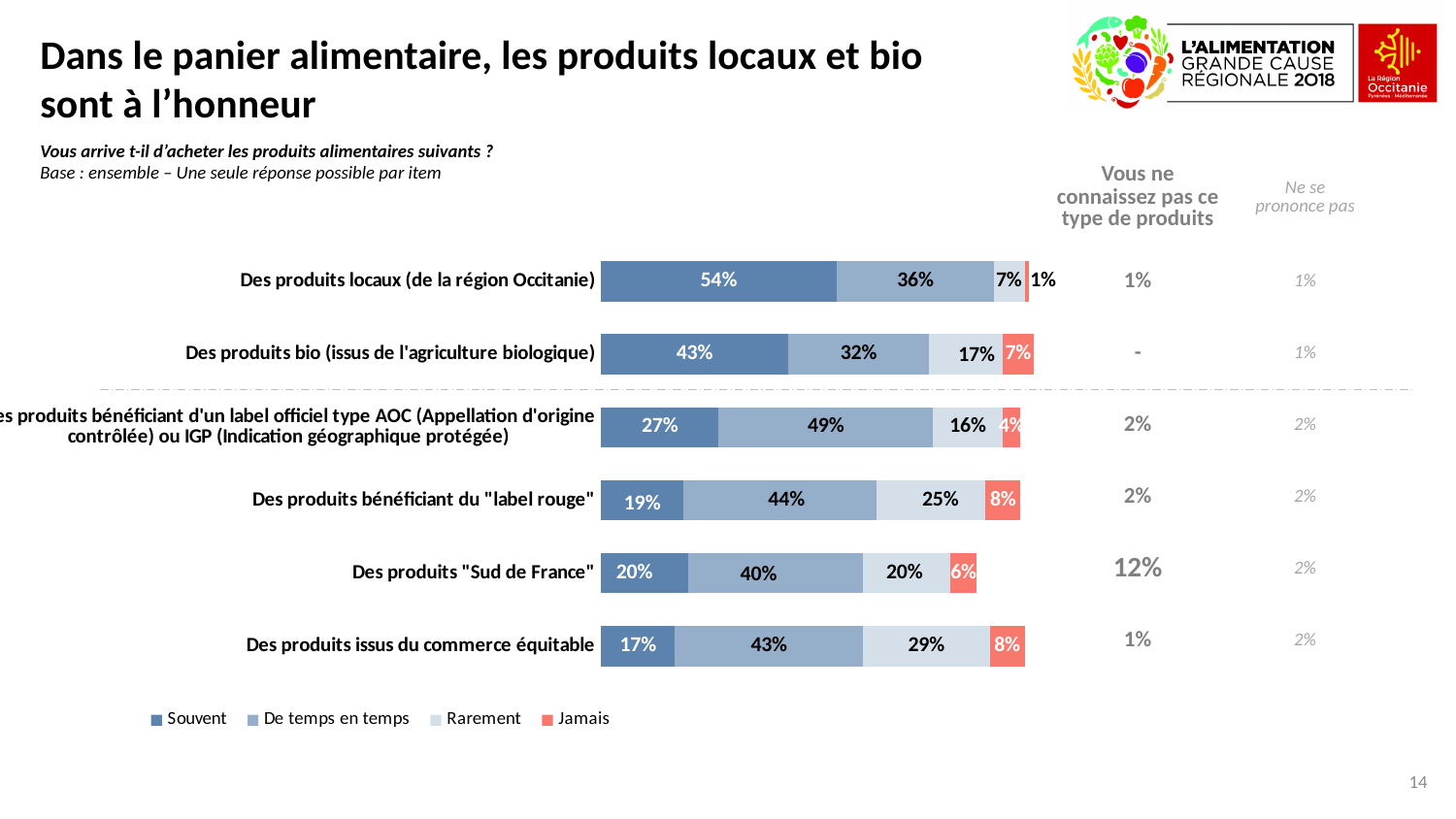
What kind of chart is shown on the slide? Stacked bar chart Which product category has the highest "Souvent" value? Des produits locaux (de la région Occitanie) Which is larger: the "Rarement" value for "Des produits bénéficiant du "label rouge"" or for "Des produits "Sud de France""? Des produits bénéficiant du "label rouge" In the "Vous ne connaissez pas ce type de produits" column, which product category has the highest value? Des produits "Sud de France" What is the "Rarement" value for "Des produits issus du commerce équitable"? 29% What is the "Souvent" value for "Des produits locaux (de la région Occitanie)"? 54% What is the difference between the "De temps en temps" values for the AOC/IGP products and "Des produits bio"? 17% Which product category has the lowest "Souvent" value? Des produits issus du commerce équitable What is the total of the four stacked segments for "Des produits "Sud de France""? 86% How many series does the legend list? 4 What is the "Jamais" value for "Des produits bio (issus de l'agriculture biologique)"? 7% How many product categories are plotted in the chart? 6